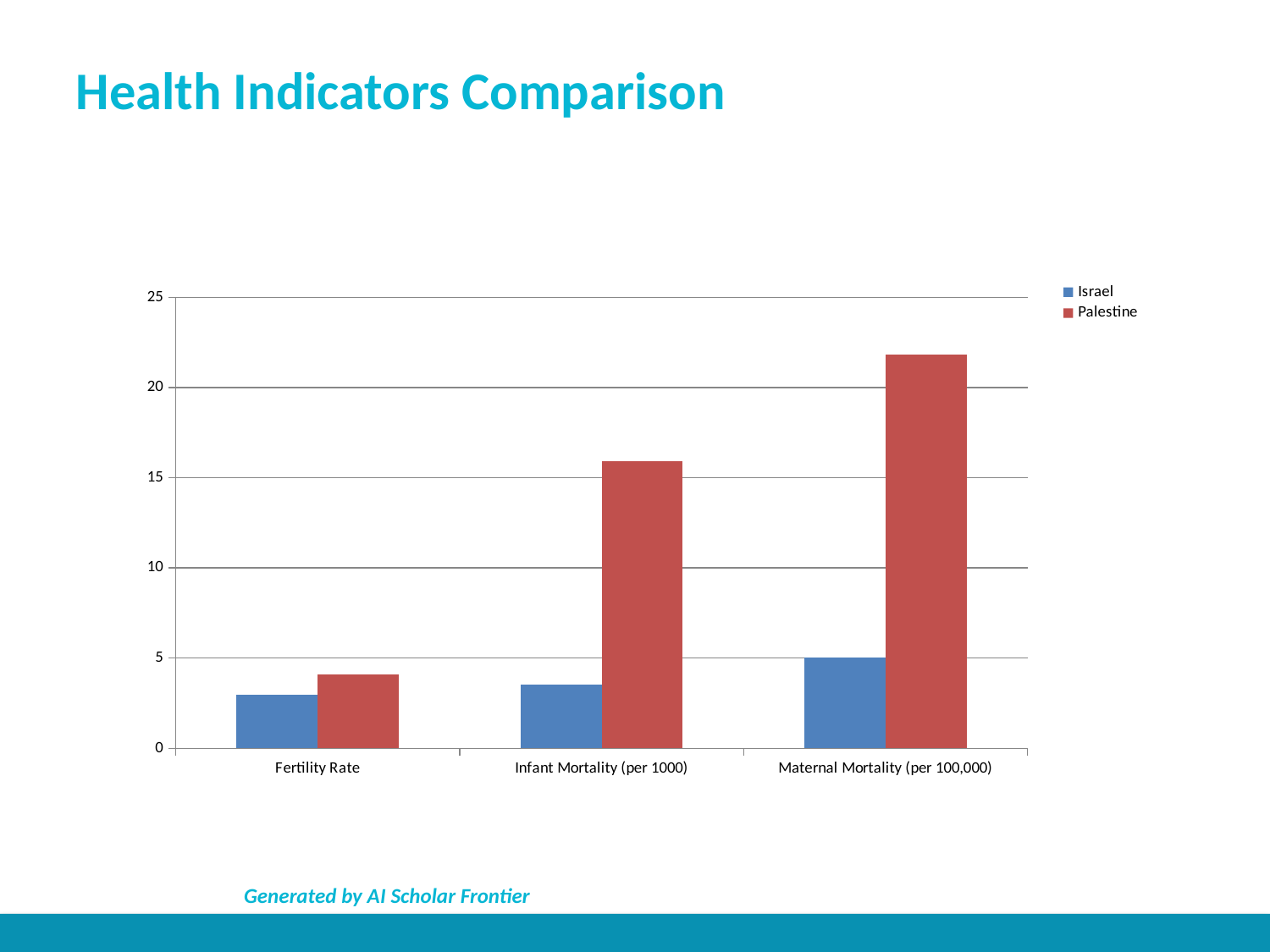
Which series is shown in red? Palestine Is the Israel value for Fertility Rate greater or less than 5? less How many series does the legend list? 2 What is the title of the slide? Health Indicators Comparison For which category is the Israel bar lowest? Fertility Rate For Infant Mortality (per 1000), which series has the larger value, Israel or Palestine? Palestine For which category is the Palestine bar highest? Maternal Mortality (per 100,000) What kind of chart is shown on the slide? bar chart Is the Palestine value for Fertility Rate greater or less than 5? less Is the Palestine value for Maternal Mortality (per 100,000) greater or less than 20? greater How many categories are shown on the x axis? 3